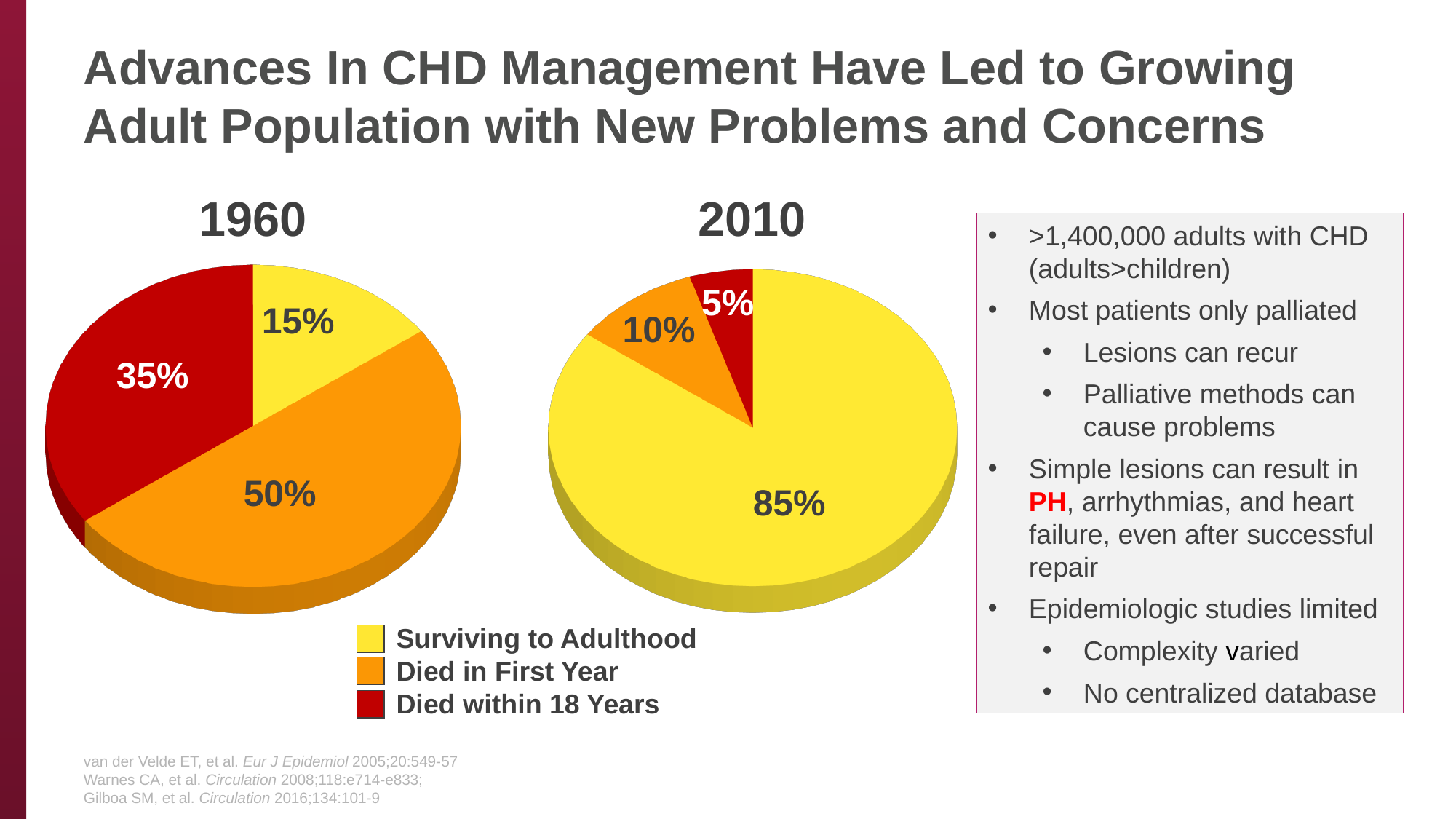
In the 1960 pie chart, what percentage is shown for Surviving to Adulthood? 15% What type of chart is used for the 1960 and 2010 data? Pie chart In the 1960 pie chart, which category has the largest share? Died in First Year How many categories does the legend list for the pie charts? 3 What is the difference between the Surviving to Adulthood share in the 2010 chart and in the 1960 chart? 70% In the 1960 pie chart, what percentage is shown for Died within 18 Years? 35% In the 2010 pie chart, what percentage is shown for Died within 18 Years? 5% In the 2010 pie chart, what percentage is shown for Died in First Year? 10% In the 2010 pie chart, which category has the smallest share? Died within 18 Years In the 1960 pie chart, which is larger: Died within 18 Years or Surviving to Adulthood? Died within 18 Years In the 2010 pie chart, what percentage is shown for Surviving to Adulthood? 85% In the 1960 pie chart, what percentage is shown for Died in First Year? 50%